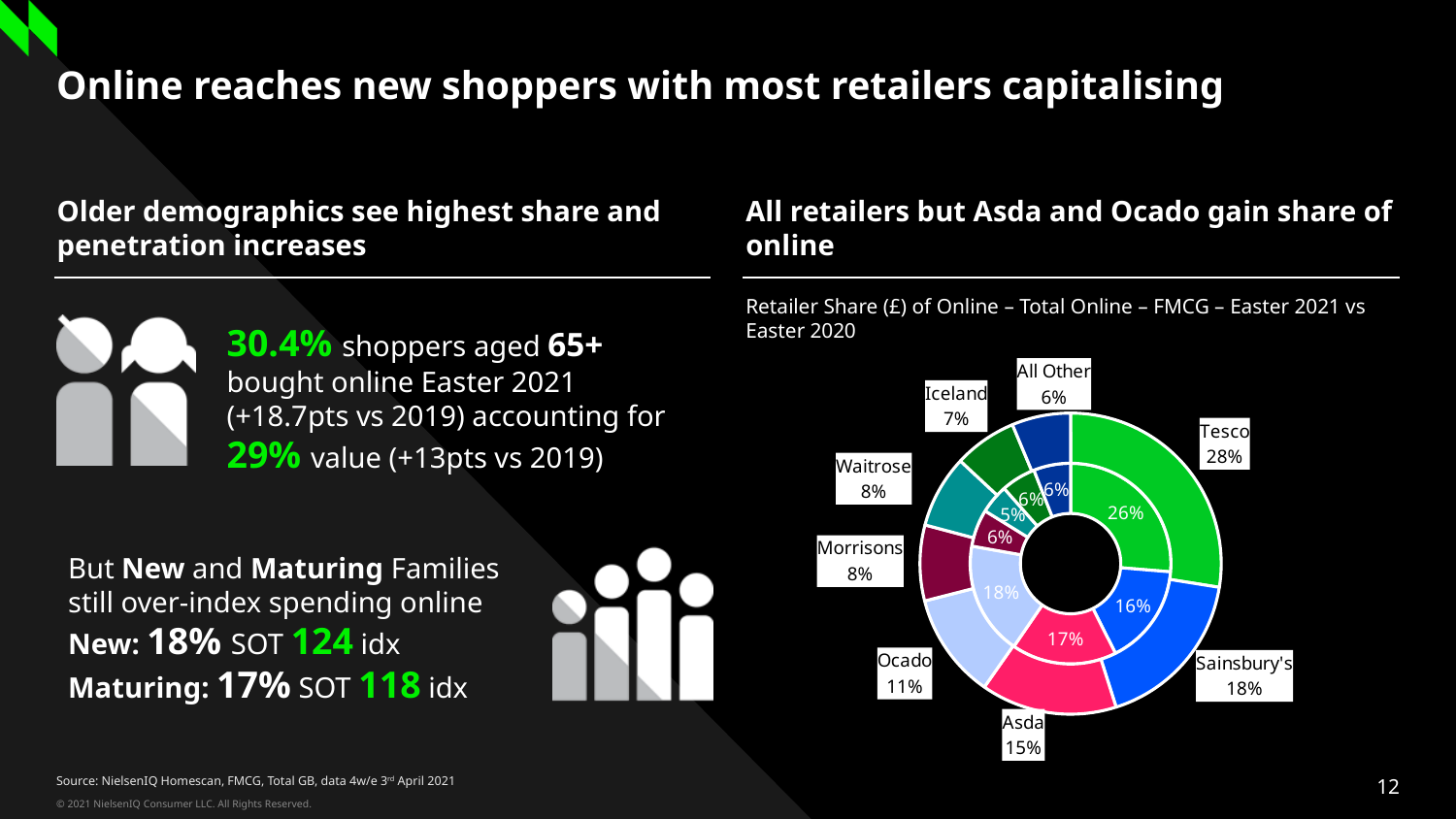
How many retailer segments are labelled on the outer ring of the doughnut chart? 8 In the doughnut chart, what is Tesco's share shown on the outer ring? 28% Which retailer has the largest share on the outer ring of the doughnut chart? Tesco In the doughnut chart, what is Ocado's share shown on the outer ring? 11% What type of chart is used to show retailer share of online? Doughnut chart What is the title of the chart on the right of the slide? Retailer Share (£) of Online – Total Online – FMCG – Easter 2021 vs Easter 2020 In the doughnut chart, what is Asda's share shown on the outer ring? 15% Which segment has the smallest share on the outer ring of the doughnut chart? All Other On the outer ring of the doughnut chart, which has the larger share, Asda or Ocado? Asda On the outer ring of the doughnut chart, how many percentage points larger is Tesco's share than Sainsbury's? 10 percentage points On the outer ring of the doughnut chart, do Morrisons and Waitrose have the same share? Yes, 8% In the doughnut chart, what is Sainsbury's share shown on the outer ring? 18%